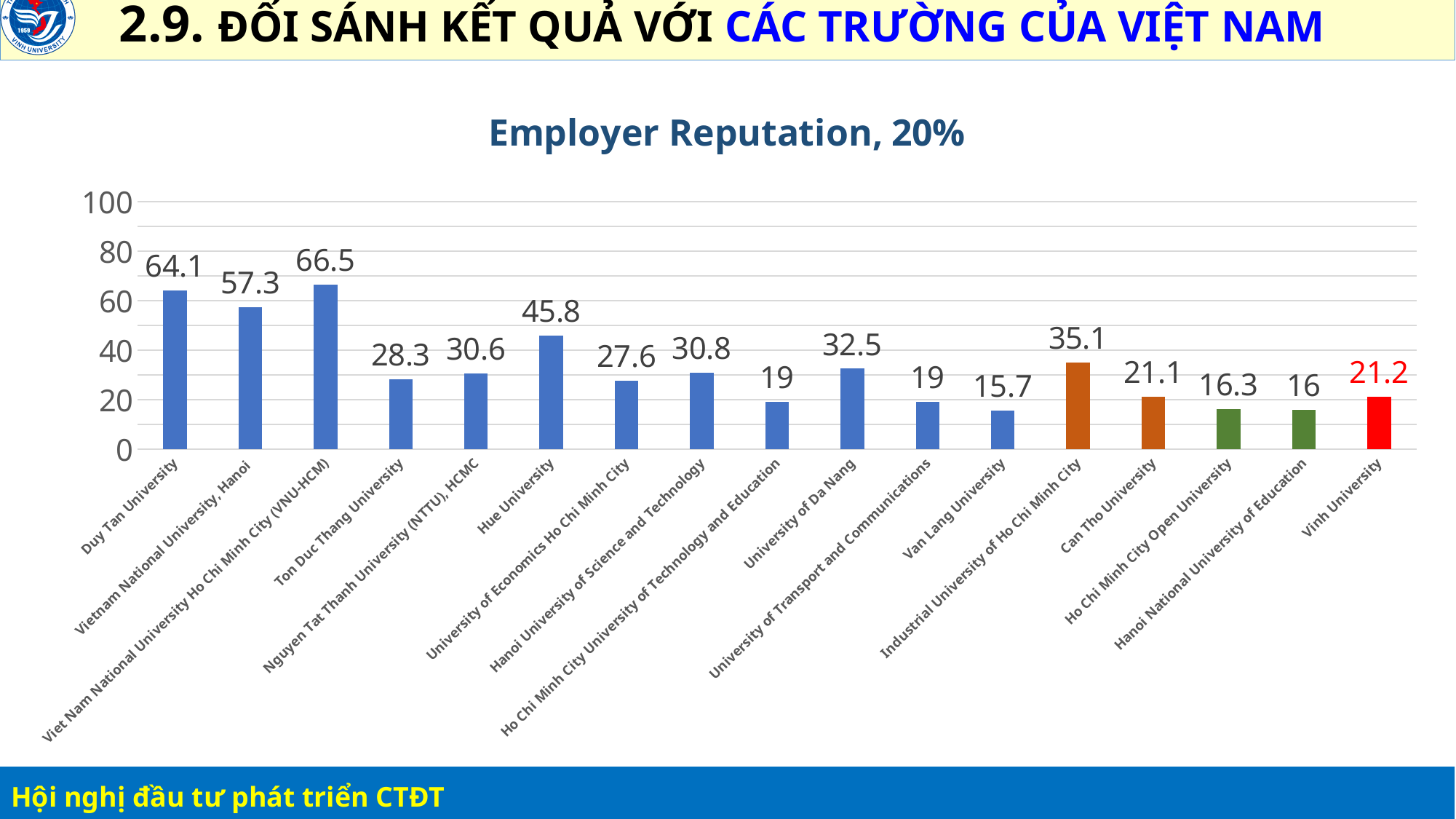
Which university has the lowest Employer Reputation value? Van Lang University What is the Employer Reputation value for Vinh University? 21.2 What is the difference between the Employer Reputation values of Duy Tan University and Vietnam National University, Hanoi? 6.8 How many universities are shown in the chart? 17 What is the Employer Reputation value for Industrial University of Ho Chi Minh City? 35.1 What type of chart is shown on the slide? Bar chart Which university has the highest Employer Reputation value? Viet Nam National University Ho Chi Minh City (VNU-HCM) What is the difference between the Employer Reputation values of Vinh University and Can Tho University? 0.1 What is the Employer Reputation value for Hue University? 45.8 What is the title of the chart? Employer Reputation, 20% Which has a higher Employer Reputation value, University of Da Nang or Ton Duc Thang University? University of Da Nang What colour is the bar for Vinh University? Red